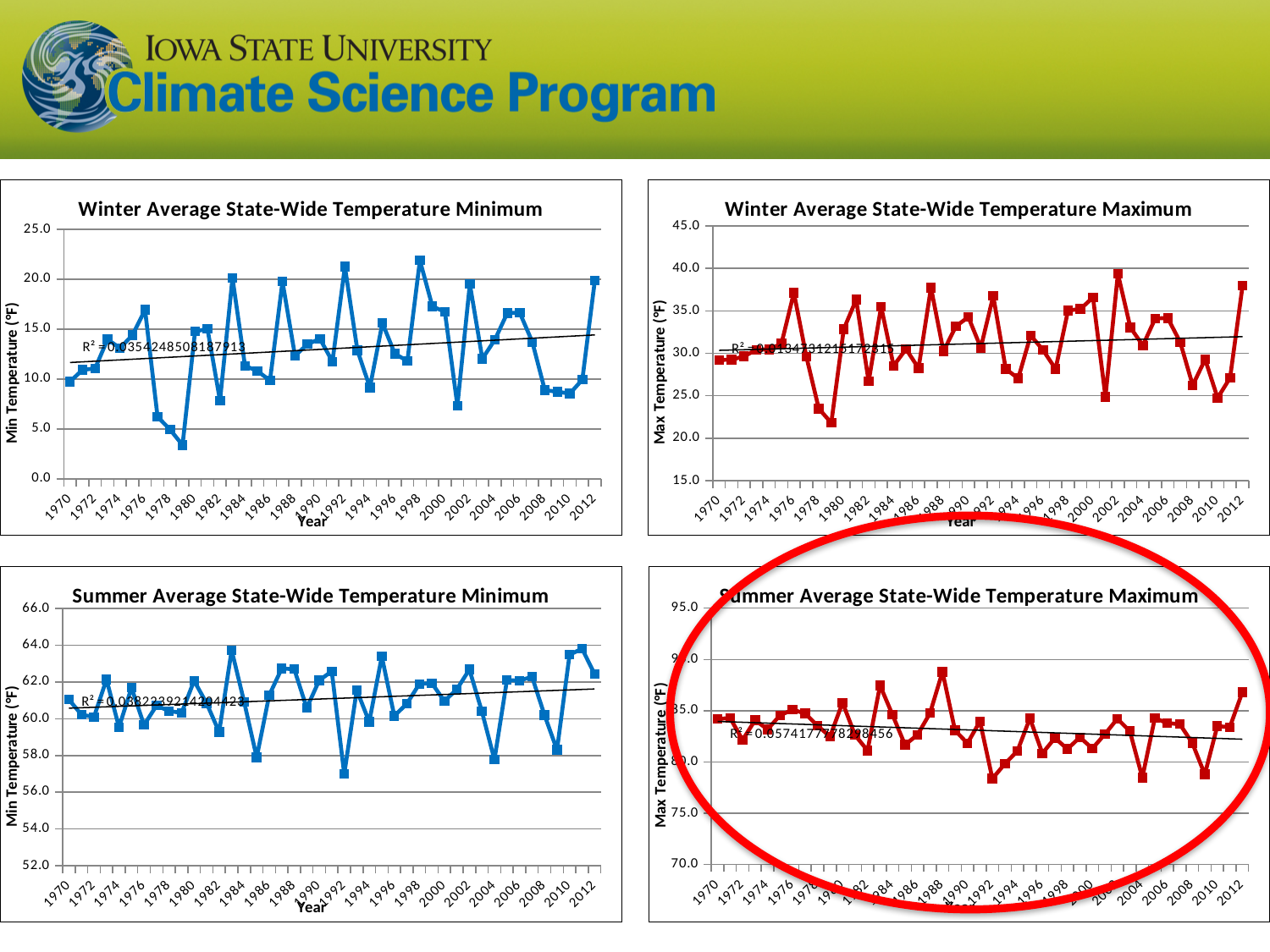
In the Winter Average State-Wide Temperature Maximum chart, is the value for 2002 greater or less than 35.0? greater In the Summer Average State-Wide Temperature Maximum chart, is the value for 1992 greater or less than 80.0? less Which chart on the slide is circled in red? Summer Average State-Wide Temperature Maximum In the Summer Average State-Wide Temperature Maximum chart, does the fitted trend line rise or fall from 1970 to 2012? fall In the Summer Average State-Wide Temperature Maximum chart, which year has the highest maximum temperature? 1988 In the Winter Average State-Wide Temperature Minimum chart, which year has the higher value, 1979 or 1998? 1998 In the Winter Average State-Wide Temperature Minimum chart, which year has the lowest minimum temperature? 1979 In the Summer Average State-Wide Temperature Minimum chart, is the value for 1992 greater or less than 58.0? less How many charts are shown on the slide? 4 What kind of chart is the Winter Average State-Wide Temperature Minimum chart? line chart In the Winter Average State-Wide Temperature Maximum chart, which year has the lowest maximum temperature? 1979